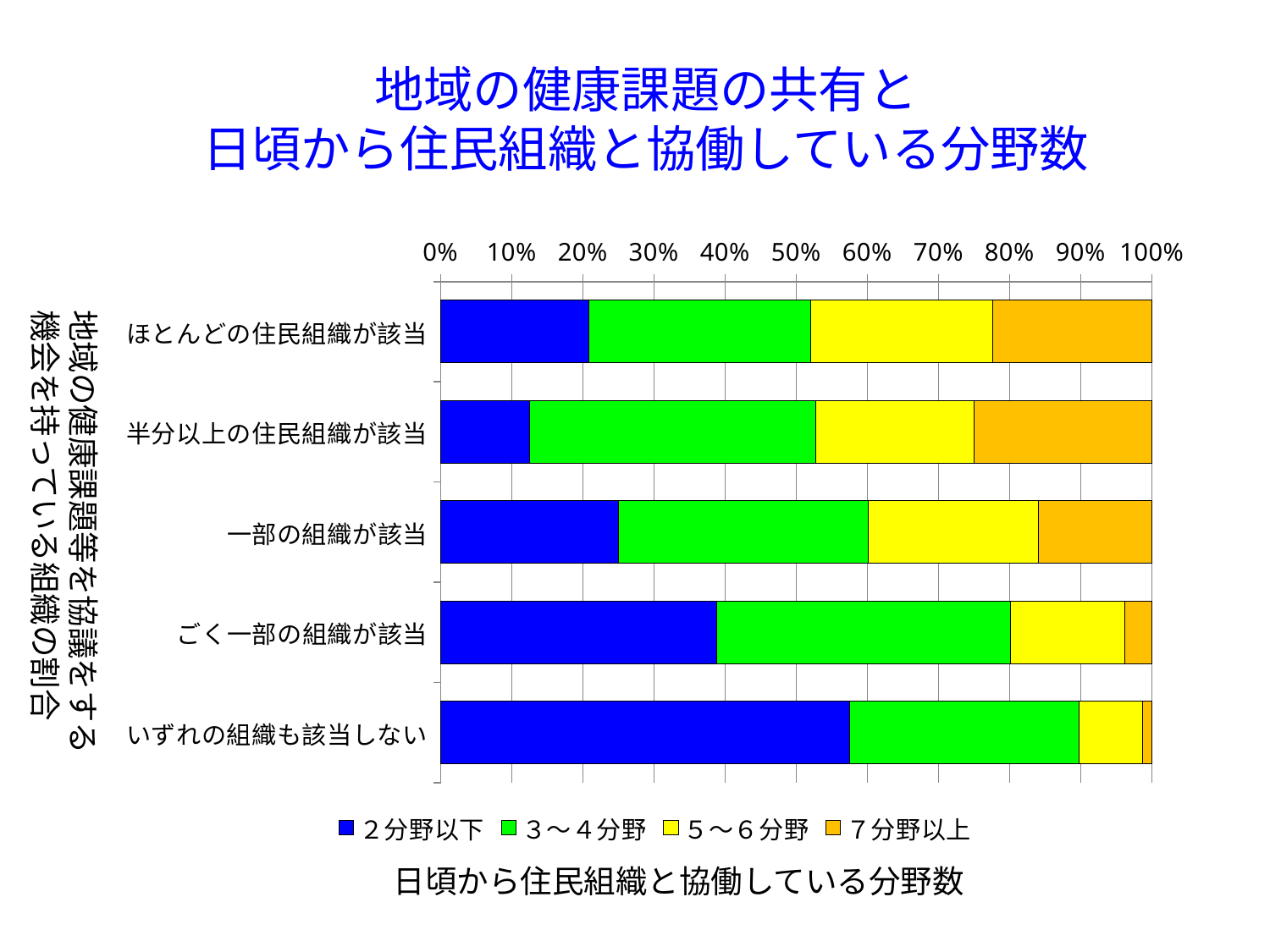
Which category has the larger 7分野以上 share: ほとんどの住民組織が該当 or いずれの組織も該当しない? ほとんどの住民組織が該当 Which colour represents the 7分野以上 series in the legend? Orange Is the 2分野以下 share for いずれの組織も該当しない greater or less than 50%? greater Is the 2分野以下 share for ごく一部の組織が該当 greater or less than 30%? greater Is the 2分野以下 share for 一部の組織が該当 greater or less than 30%? less Which category has the smallest share for 2分野以下? 半分以上の住民組織が該当 Which category has the largest share for 2分野以下? いずれの組織も該当しない What kind of chart is shown on the slide? Stacked bar chart How many series does the legend list? 4 How many categories are plotted on the vertical axis of the chart? 5 What is the title of the chart? 地域の健康課題の共有と日頃から住民組織と協働している分野数